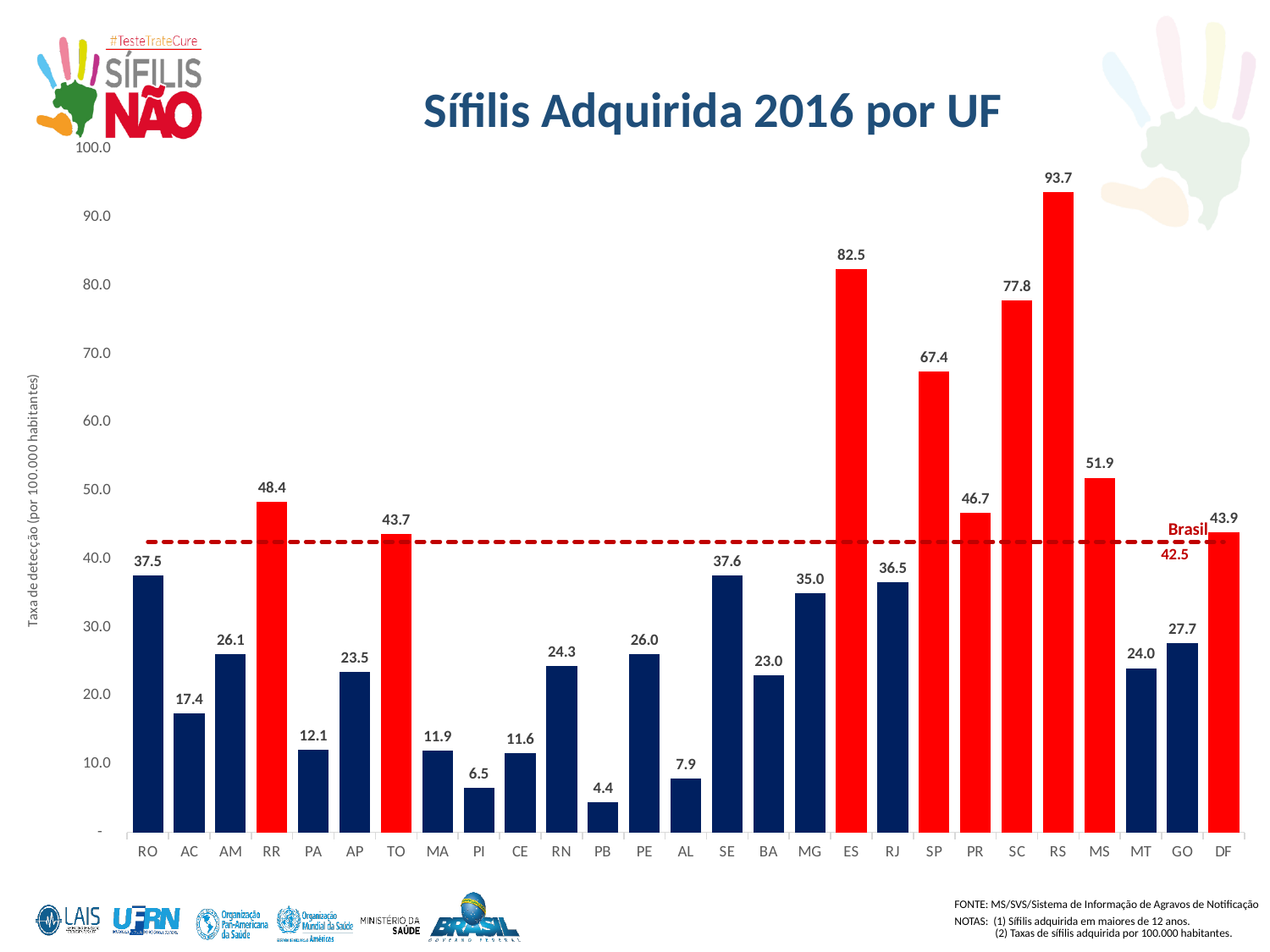
What is the value for RS? 93.7 Which UF has the lowest detection rate? PB What is the title of the chart? Sífilis Adquirida 2016 por UF Which UF has the highest detection rate? RS What is the value for PB? 4.4 What is the value for SP? 67.4 Which has a larger value, RR or PR? RR What is the difference between the values for ES and SC? 4.7 What kind of chart is shown on the slide? Bar chart Is the value for MG greater or less than 40.0? less What value does the dashed 'Brasil' reference line mark? 42.5 How many UFs (bars) are shown on the chart? 27